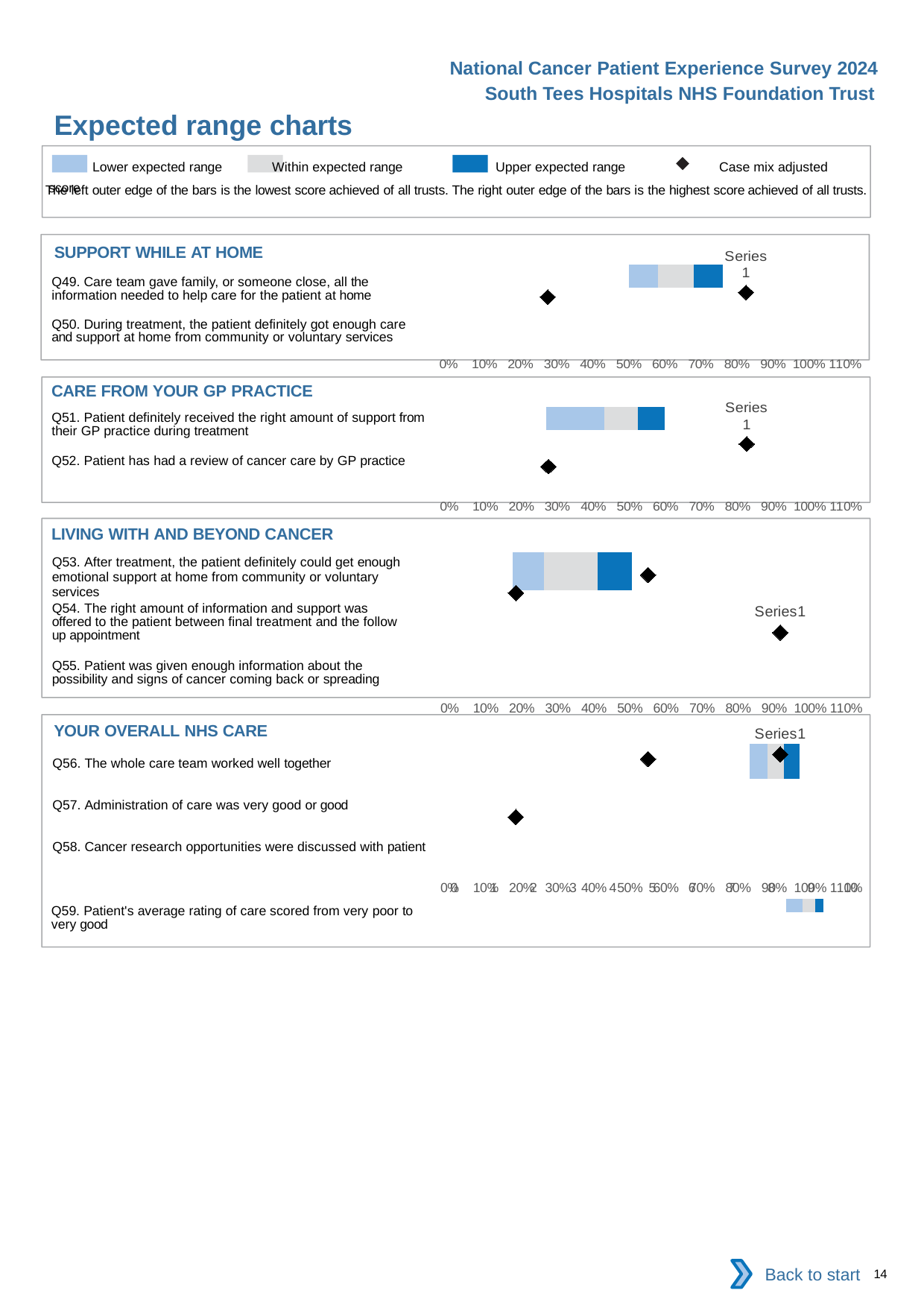
In the CARE FROM YOUR GP PRACTICE chart, is the right edge of the expected range bar greater or less than 70%? less In the LIVING WITH AND BEYOND CANCER chart, is the rightmost diamond marker greater or less than 80%? greater How many entries does the legend at the top of the slide list? 4 In the YOUR OVERALL NHS CARE chart, is the leftmost diamond marker greater or less than 30%? less What does the dark blue colour in the legend represent? Upper expected range How many questions are listed in the LIVING WITH AND BEYOND CANCER chart? 3 How many questions are listed in the YOUR OVERALL NHS CARE chart? 4 What kind of chart is used in the CARE FROM YOUR GP PRACTICE section? bar chart What does the diamond marker in the legend represent? Case mix adjusted score How many questions are listed in the SUPPORT WHILE AT HOME chart? 2